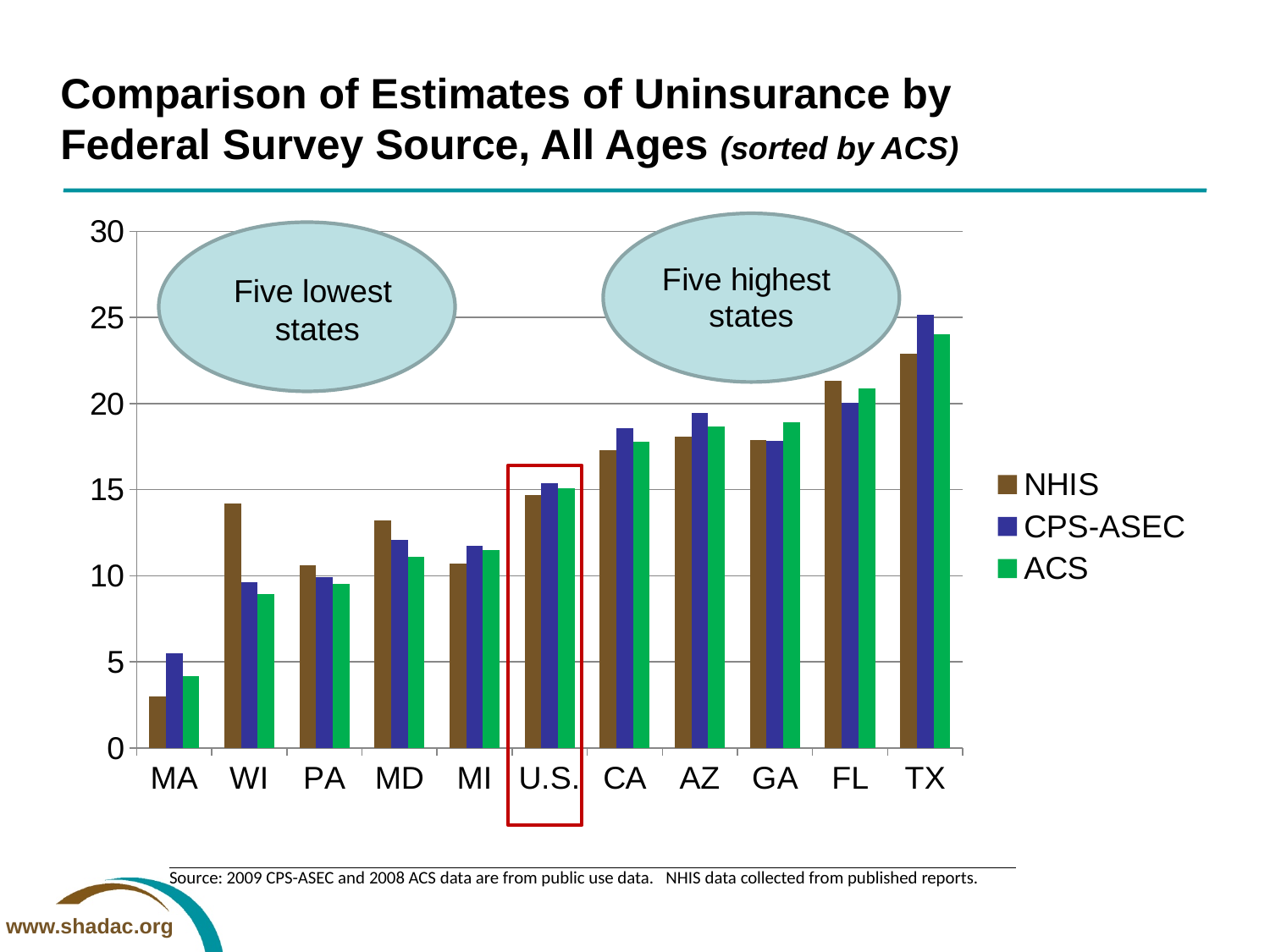
Which category has the lowest ACS value? MA Which series is shown in green in the legend? ACS Is the NHIS value for WI greater or less than 15? less Is the ACS value for GA greater or less than 20? less Which category has the highest ACS value? TX Is the NHIS value for TX greater or less than 20? greater How many series does the legend list? 3 How many categories are shown along the x axis? 11 Do the ACS values rise or fall moving from MA to TX along the x axis? rise What kind of chart is shown on the slide? bar chart For WI, which is larger: the NHIS value or the ACS value? NHIS